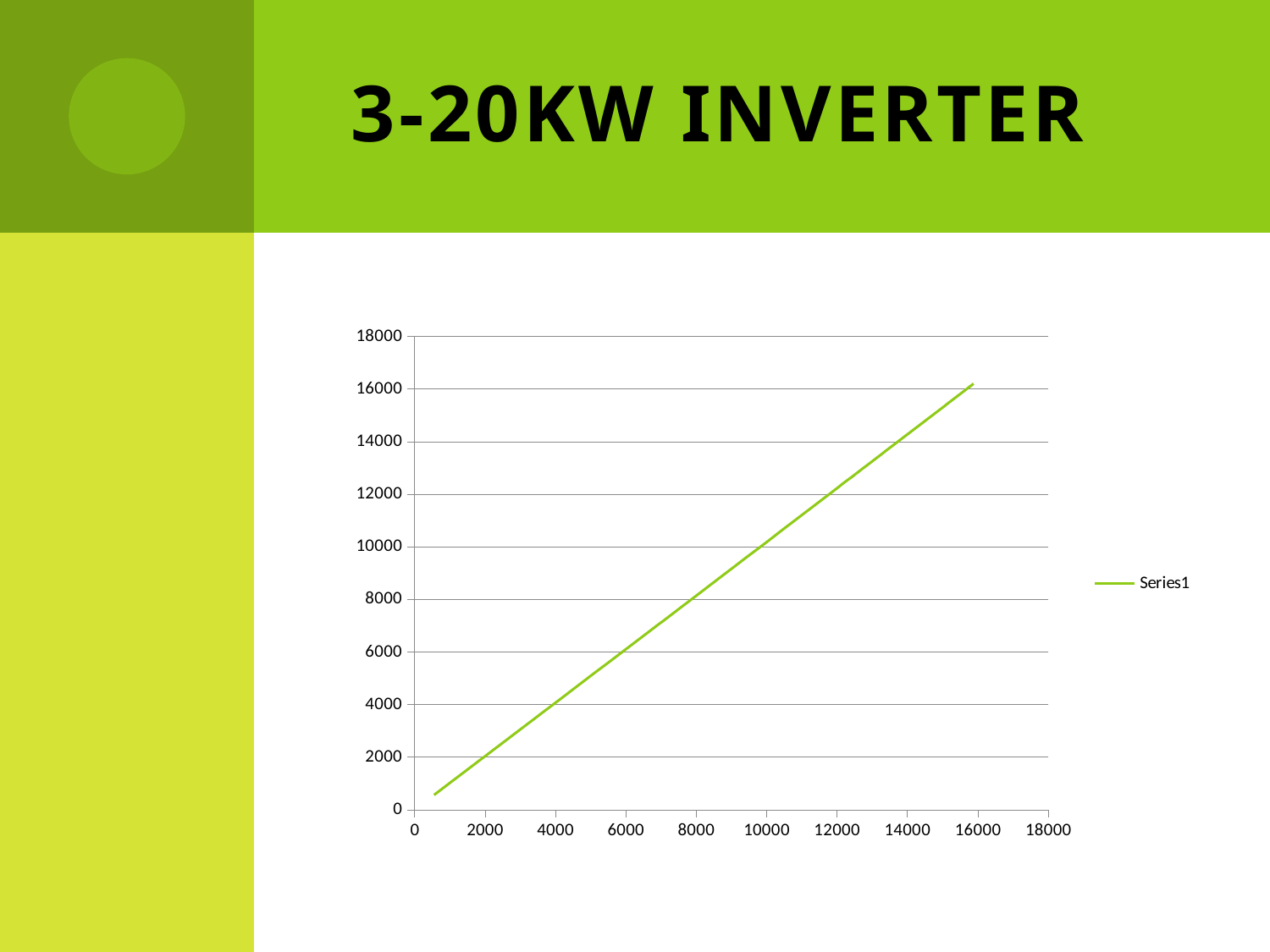
Is the value of Series1 at x = 12000 greater or less than 10000? greater Is the value of Series1 at x = 8000 greater or less than 6000? greater Is the value of Series1 at x = 14000 greater or less than 12000? greater What is the name of the series shown in the legend? Series1 What is the maximum value shown on the vertical axis? 18000 Do the values of Series1 rise or fall as the x axis increases? rise What kind of chart is shown on the slide? line chart How many series does the chart's legend list? 1